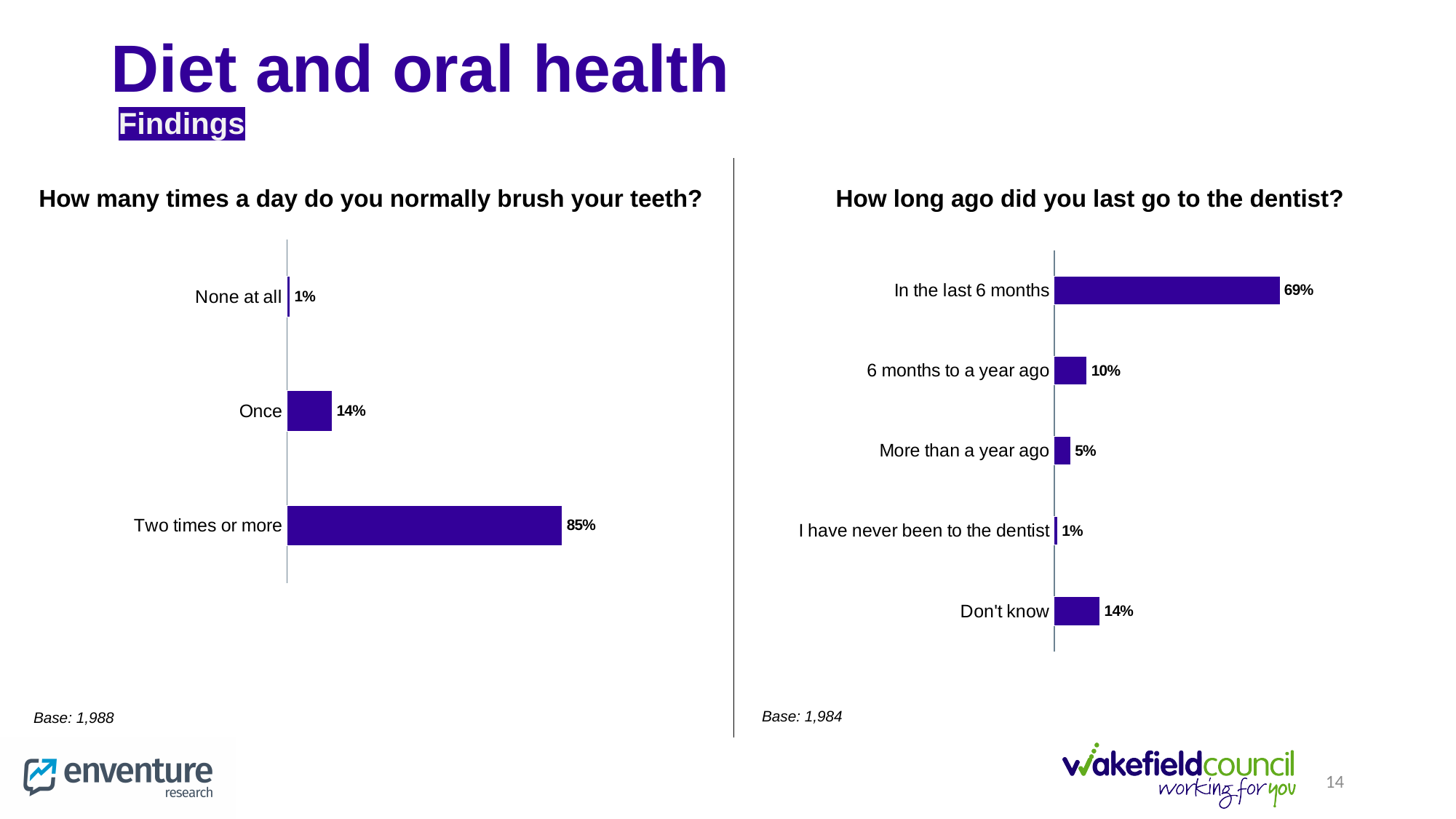
In the chart 'How long ago did you last go to the dentist?', which is larger: '6 months to a year ago' or 'Don't know'? Don't know In the chart 'How long ago did you last go to the dentist?', what is the value for 'More than a year ago'? 5% In the chart 'How long ago did you last go to the dentist?', what percentage went in the last 6 months? 69% What type of chart is used on the right side of the slide for 'How long ago did you last go to the dentist?'? Bar chart In the chart 'How many times a day do you normally brush your teeth?', what percentage of respondents brush their teeth two times or more? 85% In the chart 'How long ago did you last go to the dentist?', what is the difference between 'In the last 6 months' and '6 months to a year ago'? 59% In the chart 'How many times a day do you normally brush your teeth?', what is the value for 'Once'? 14% In the chart 'How many times a day do you normally brush your teeth?', what is the difference between 'Two times or more' and 'Once'? 71% In the chart 'How long ago did you last go to the dentist?', how many categories are shown? 5 In the chart 'How long ago did you last go to the dentist?', which category has the highest value? In the last 6 months In the chart 'How many times a day do you normally brush your teeth?', how many categories are shown? 3 In the chart 'How many times a day do you normally brush your teeth?', which category has the lowest value? None at all